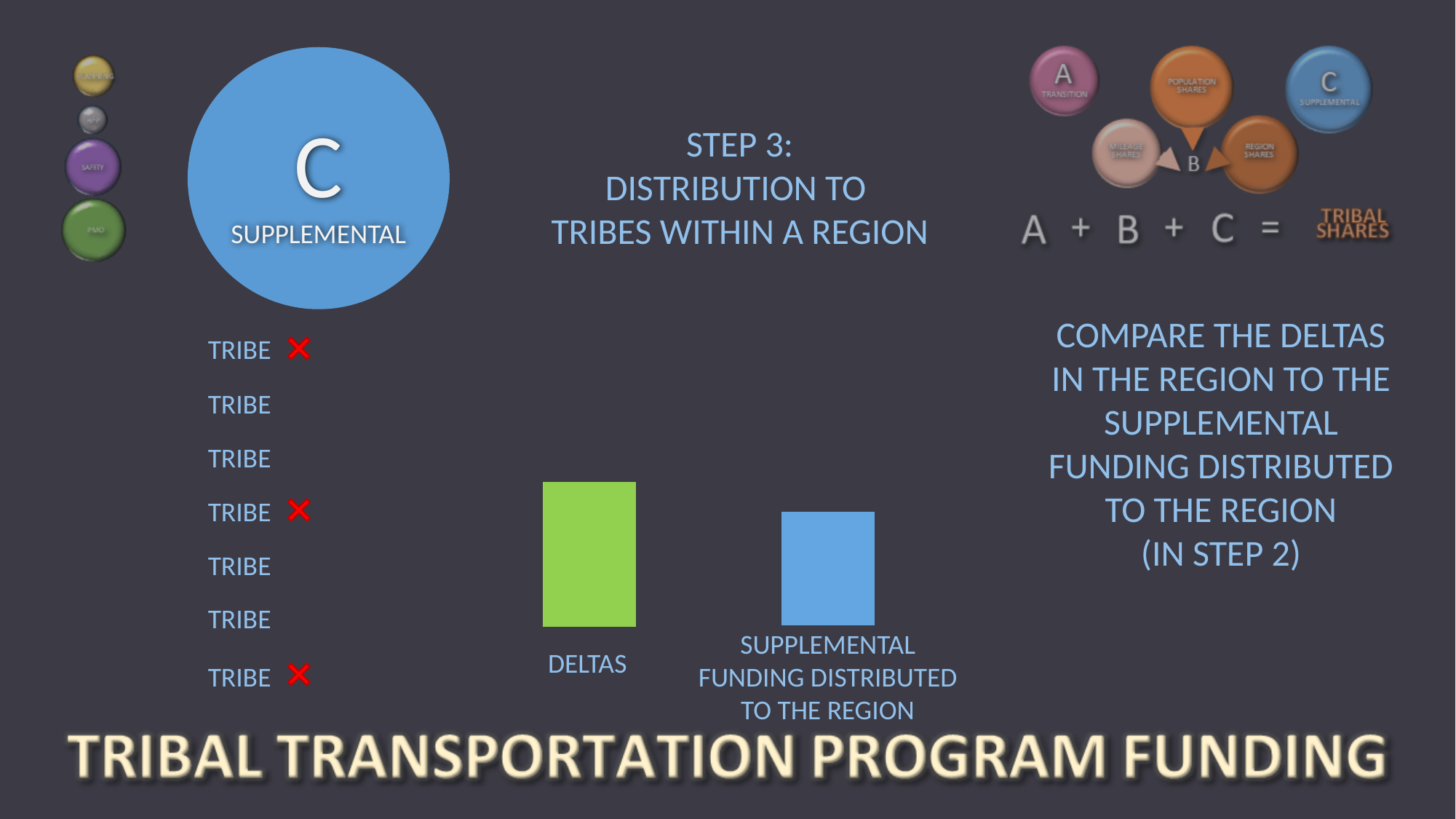
How many bars does the chart on the slide have? 2 What kind of chart is shown in the lower middle of the slide? bar chart Which category has the highest bar in the chart? DELTAS What colour is the SUPPLEMENTAL FUNDING DISTRIBUTED TO THE REGION bar in the chart? blue Which bar in the chart is taller, DELTAS or SUPPLEMENTAL FUNDING DISTRIBUTED TO THE REGION? DELTAS Is the SUPPLEMENTAL FUNDING DISTRIBUTED TO THE REGION bar taller or shorter than the DELTAS bar? shorter What colour is the DELTAS bar in the chart? green Which category has the lowest bar in the chart? SUPPLEMENTAL FUNDING DISTRIBUTED TO THE REGION